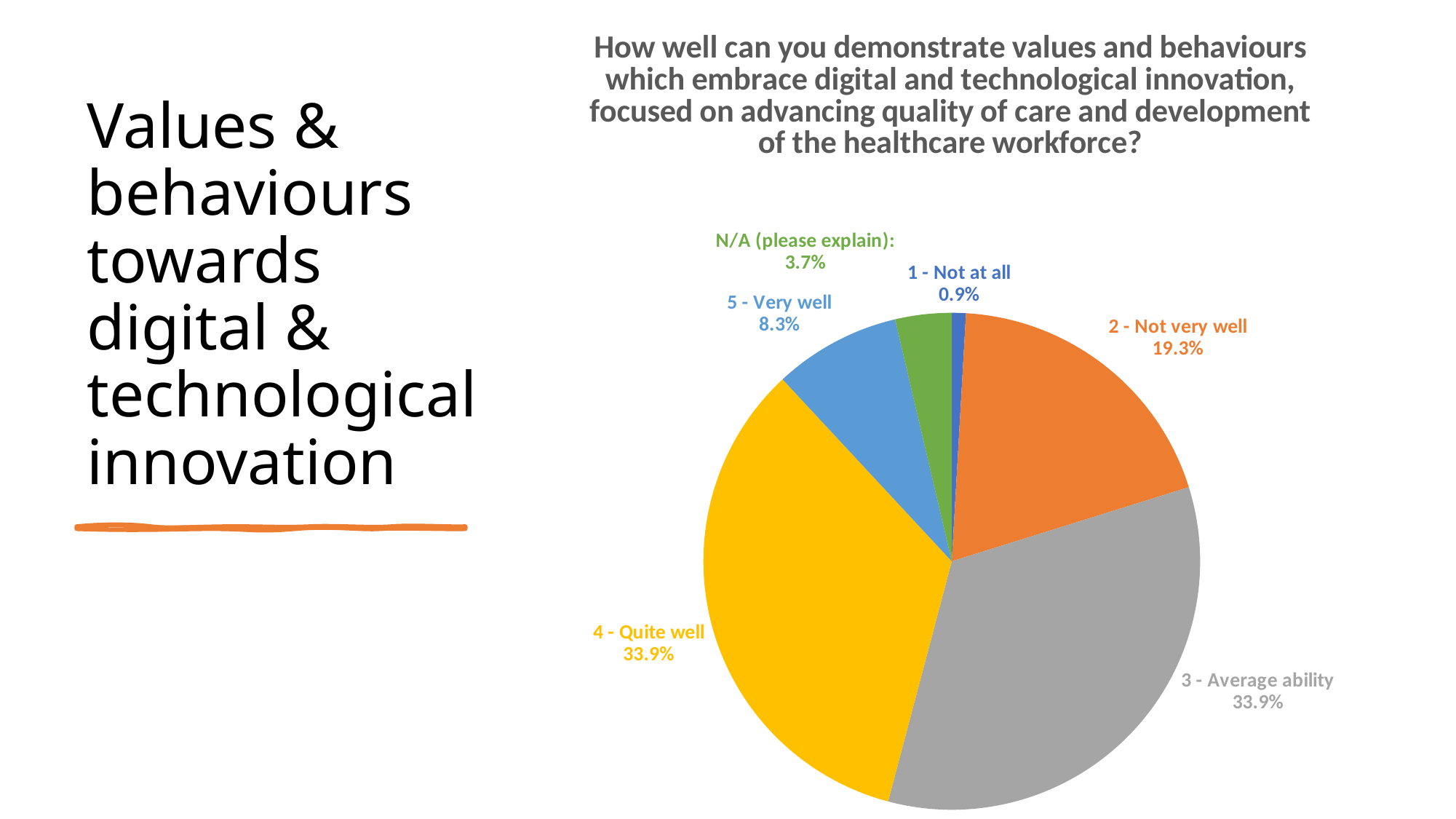
What is the difference in percentage points between "4 - Quite well" and "2 - Not very well"? 14.6% What colour is the slice for "4 - Quite well"? Yellow How many response categories are shown in the pie chart? 6 What percentage of respondents answered "3 - Average ability"? 33.9% What percentage is shown for "5 - Very well"? 8.3% Which is larger: the share for "2 - Not very well" or the share for "5 - Very well"? 2 - Not very well What type of chart is shown on the slide? Pie chart What is the difference in percentage points between "2 - Not very well" and "5 - Very well"? 11.0% Which response category has the smallest slice of the pie? 1 - Not at all What is the combined percentage for "3 - Average ability" and "4 - Quite well"? 67.8% What percentage is shown for "N/A (please explain):"? 3.7% What share of the pie does "2 - Not very well" represent? 19.3%